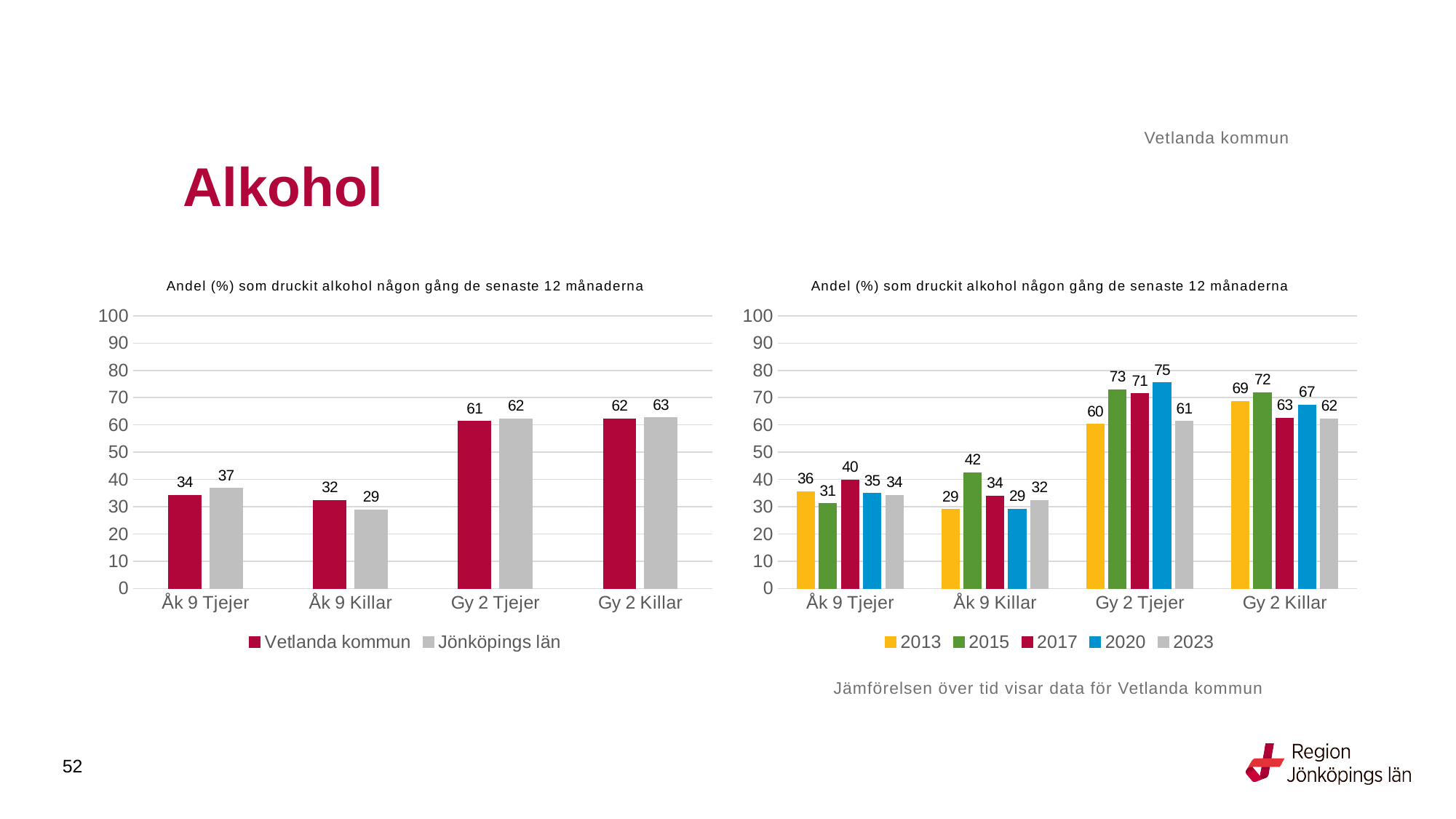
In the left chart, which category has the lowest value for Jönköpings län? Åk 9 Killar In the right chart, what is the difference between the 2013 and 2023 values for Gy 2 Killar? 7 What kind of chart is the left chart? Bar chart In the right chart, which year has the highest value for Åk 9 Killar? 2015 In the right chart, what is the value for 2020 for Gy 2 Tjejer? 75 In the right chart, which is larger for Gy 2 Tjejer: the 2013 value or the 2015 value? 2015 In the right chart, how many series does the legend list? 5 In the left chart, what is the value for Vetlanda kommun for Åk 9 Tjejer? 34 In the left chart, what is the value for Jönköpings län for Gy 2 Killar? 63 In the left chart, how many series does the legend list? 2 In the right chart, what is the value for 2017 for Åk 9 Tjejer? 40 In the left chart, what is the difference between Vetlanda kommun and Jönköpings län for Åk 9 Killar? 3